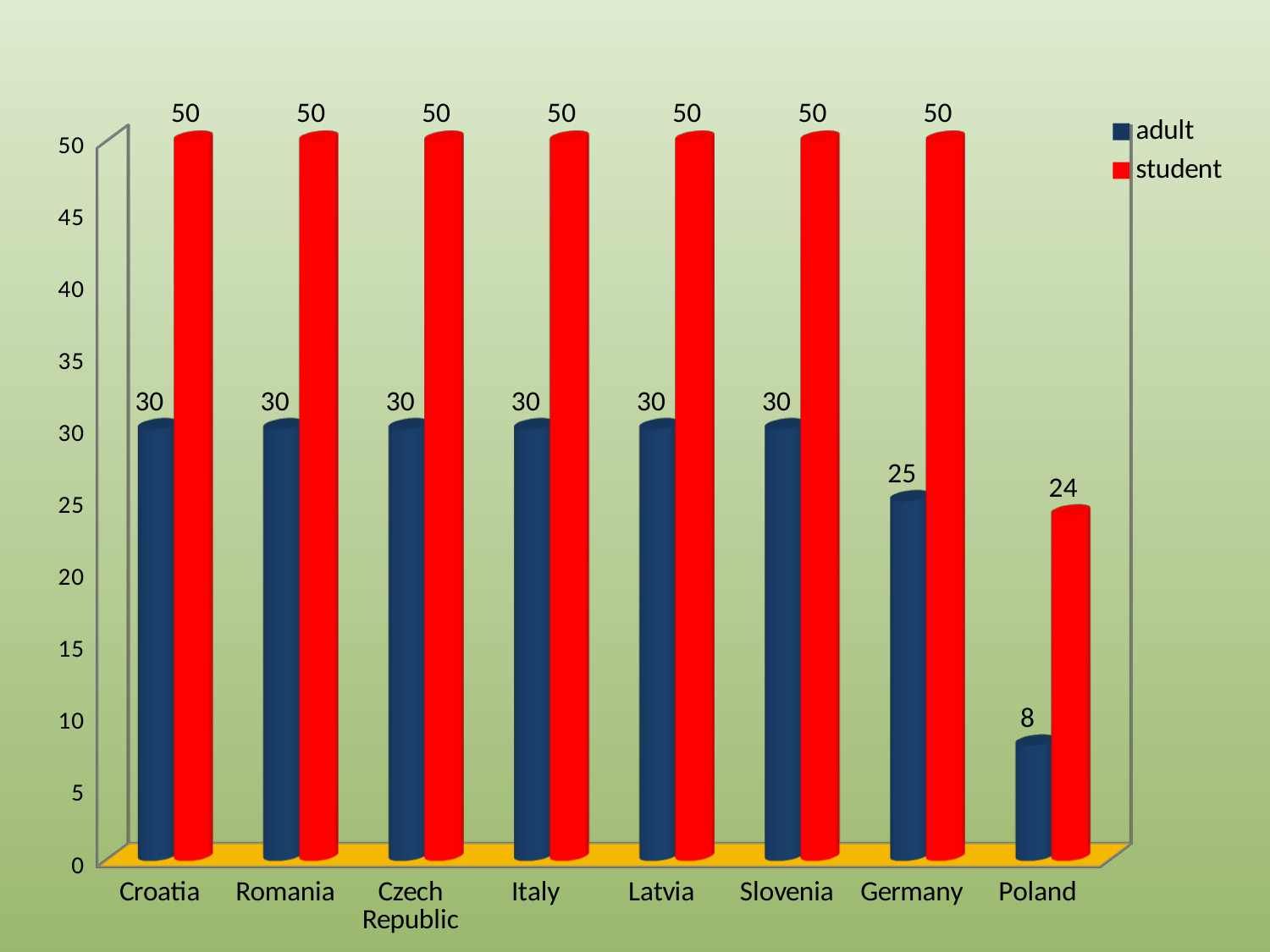
What is the adult value for Croatia? 30 What is the difference between the student and adult values for Poland? 16 What is the difference between the student and adult values for Germany? 25 Which country has the lowest adult value? Poland What colour are the student bars? red What kind of chart is shown on the slide? bar chart What is the adult value for Germany? 25 How many series does the legend list? 2 Which is larger for Italy, the adult value or the student value? student Which country has the lowest student value? Poland How many countries are shown on the x axis? 8 What is the student value for Poland? 24